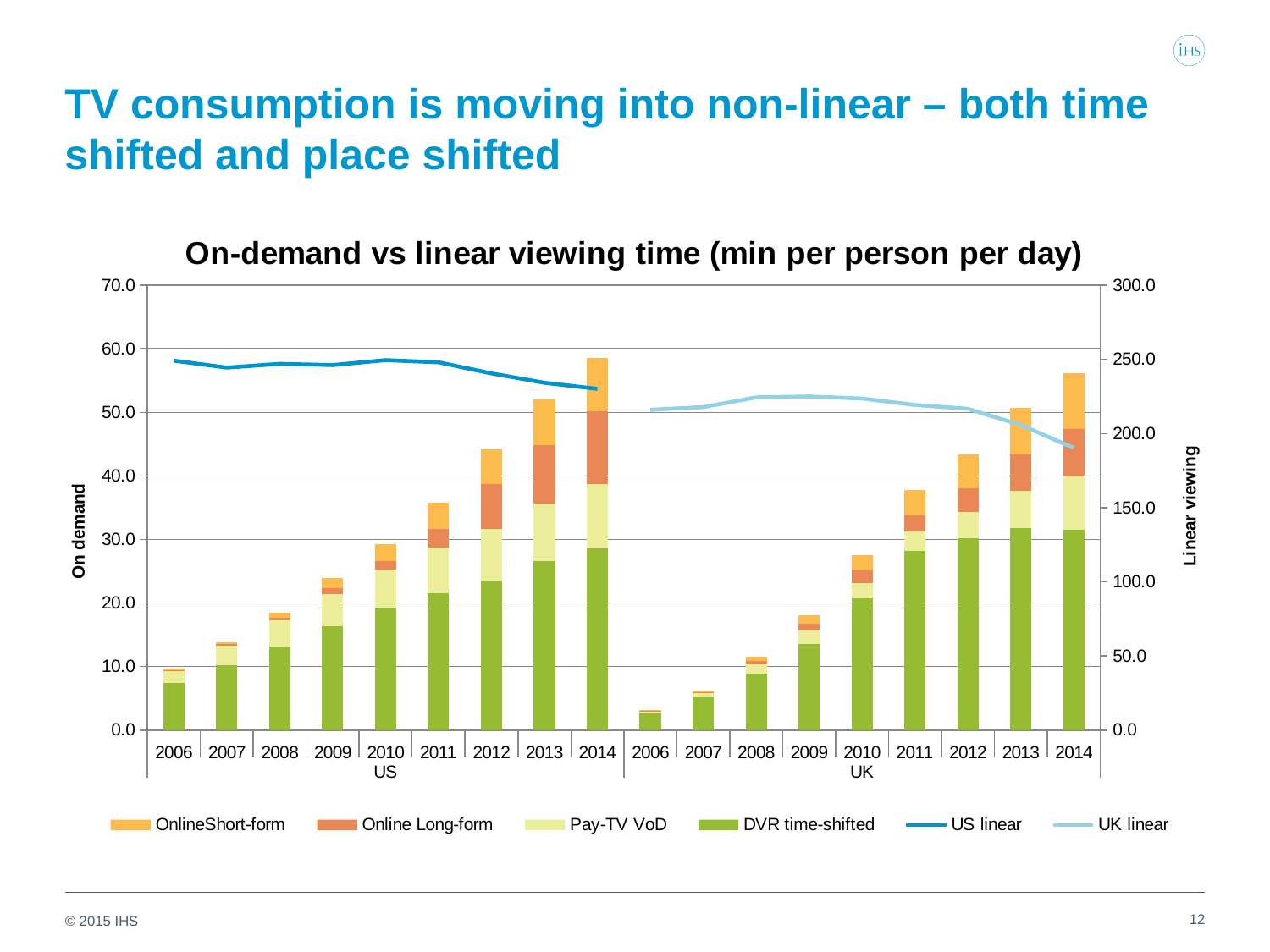
Does the US linear line rise or fall from 2006 to 2014? fall How many year categories are shown along the x axis in total across the US and UK groups? 18 What kind of chart is shown on the slide? Stacked bar chart with line series Which year and country has the shortest on-demand stacked bar? UK 2006 Is the total on-demand value for US 2014 greater or less than 50.0? greater What is the title of the right-hand vertical axis? Linear viewing Is the UK linear value in 2014 greater or less than 200.0 on the right axis? less Which year and country has the tallest on-demand stacked bar? US 2014 Which is larger in 2006: the US on-demand total or the UK on-demand total? US How many series does the legend list? 6 Does the US on-demand total rise or fall from 2006 to 2014? rise Is the total on-demand value for UK 2006 greater or less than 10.0? less